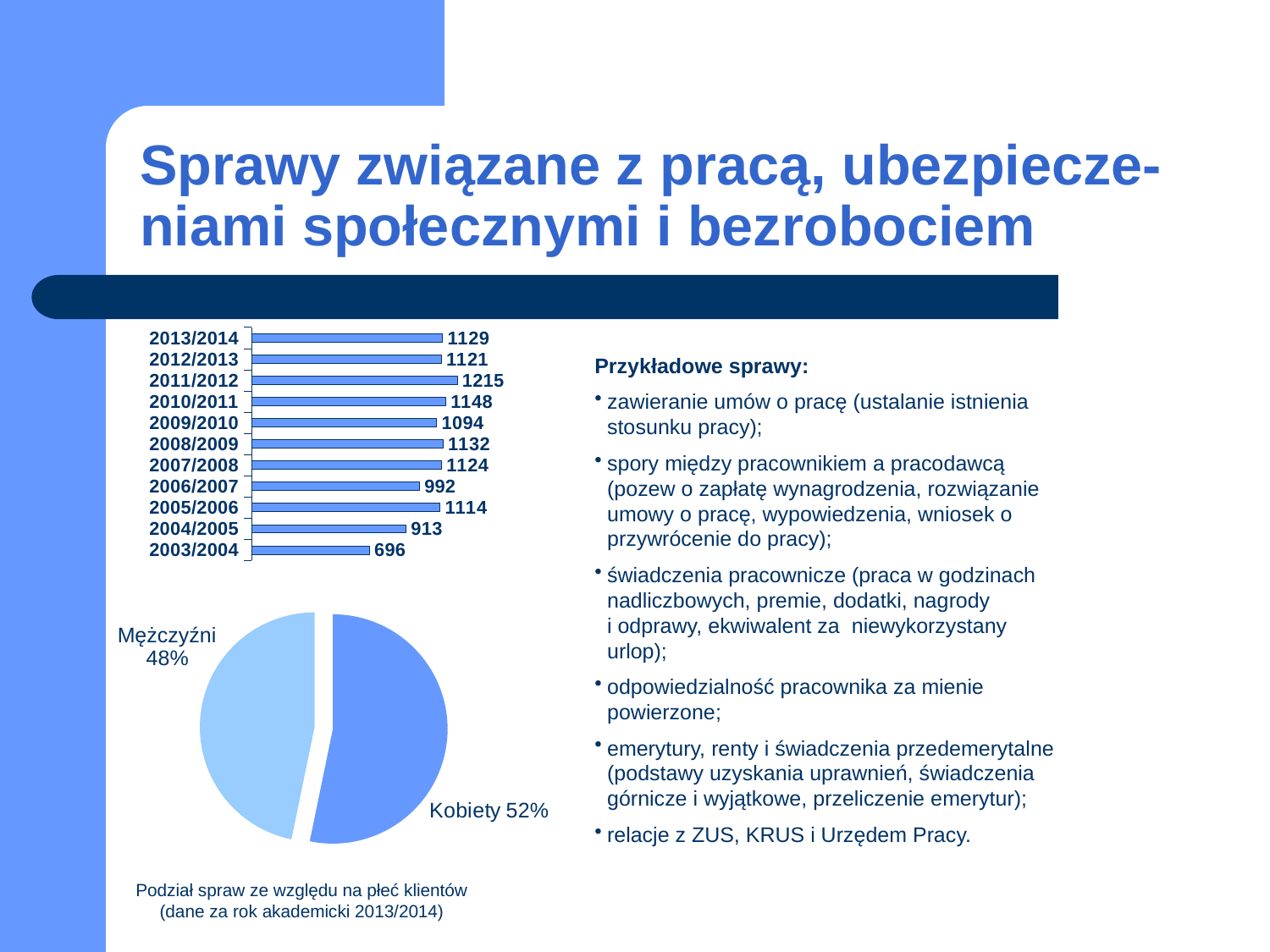
In the bar chart, which academic year has the highest value? 2011/2012 In the pie chart, which group has the larger share: Kobiety or Mężczyźni? Kobiety In the pie chart, what share is labelled Kobiety? 52% In the bar chart, what is the value for 2011/2012? 1215 In the bar chart, which academic year has the lowest value? 2003/2004 In the bar chart, which is larger: the value for 2006/2007 or the value for 2004/2005? 2006/2007 How many academic years are shown in the bar chart? 11 What type of chart is the lower chart on the slide? pie chart In the bar chart, what is the value for 2003/2004? 696 In the pie chart, what share is labelled Mężczyźni? 48% In the bar chart, what is the difference between the values for 2011/2012 and 2003/2004? 519 What type of chart is the upper chart on the slide? bar chart